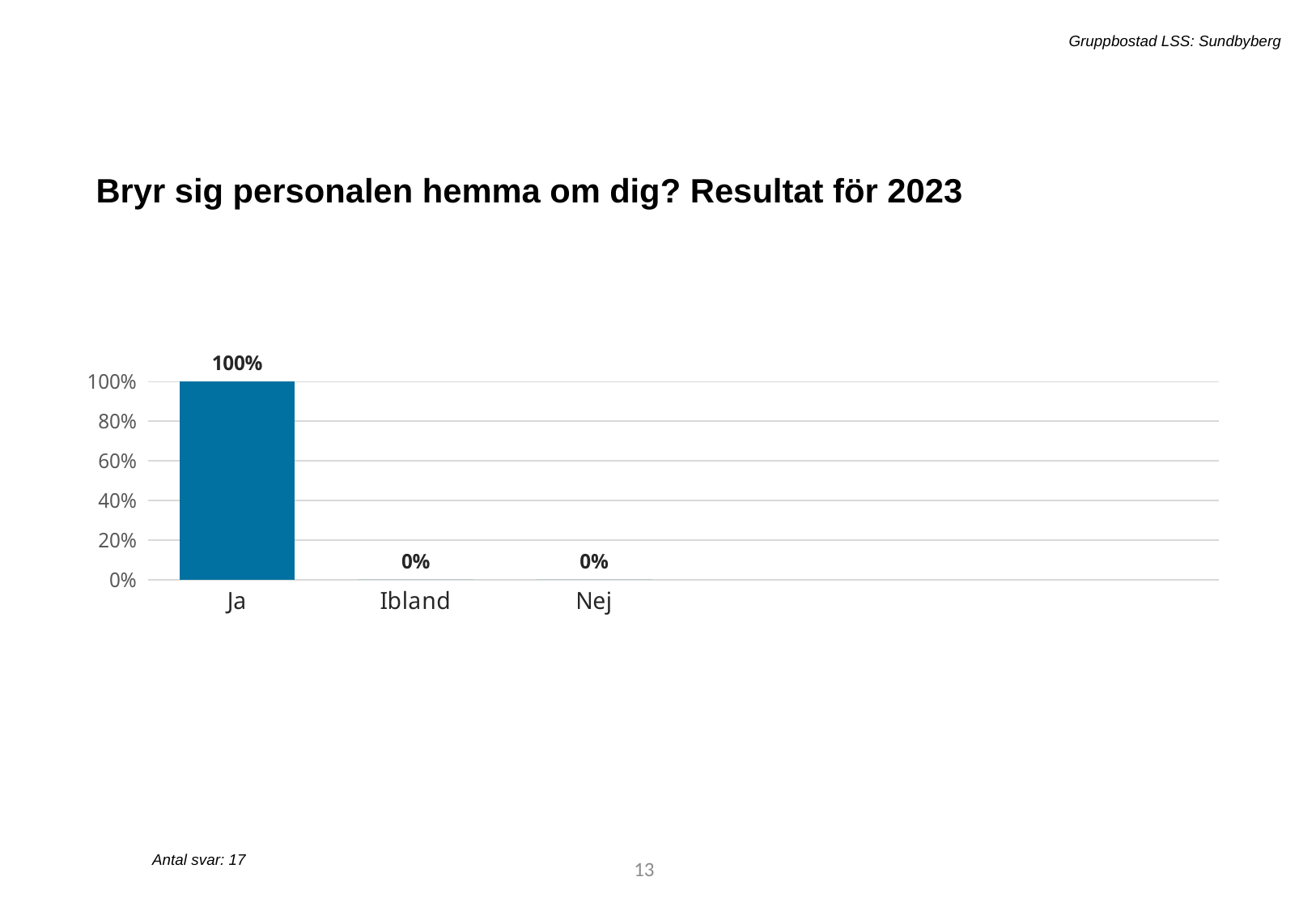
What is the value for Ja? 100% What kind of chart is shown on the slide? bar chart How many categories are shown on the x axis? 3 Do the values rise or fall from Ja to Nej along the x axis? fall What is the value for Nej? 0% What is the value for Ibland? 0% How many responses (Antal svar) does the slide report? 17 Which is larger, the value for Ja or the value for Ibland? Ja What is the title of the chart? Bryr sig personalen hemma om dig? Resultat för 2023 Is the value for Ja greater or less than 80%? greater What is the difference between the values for Ja and Nej? 100% Which category has the highest value? Ja